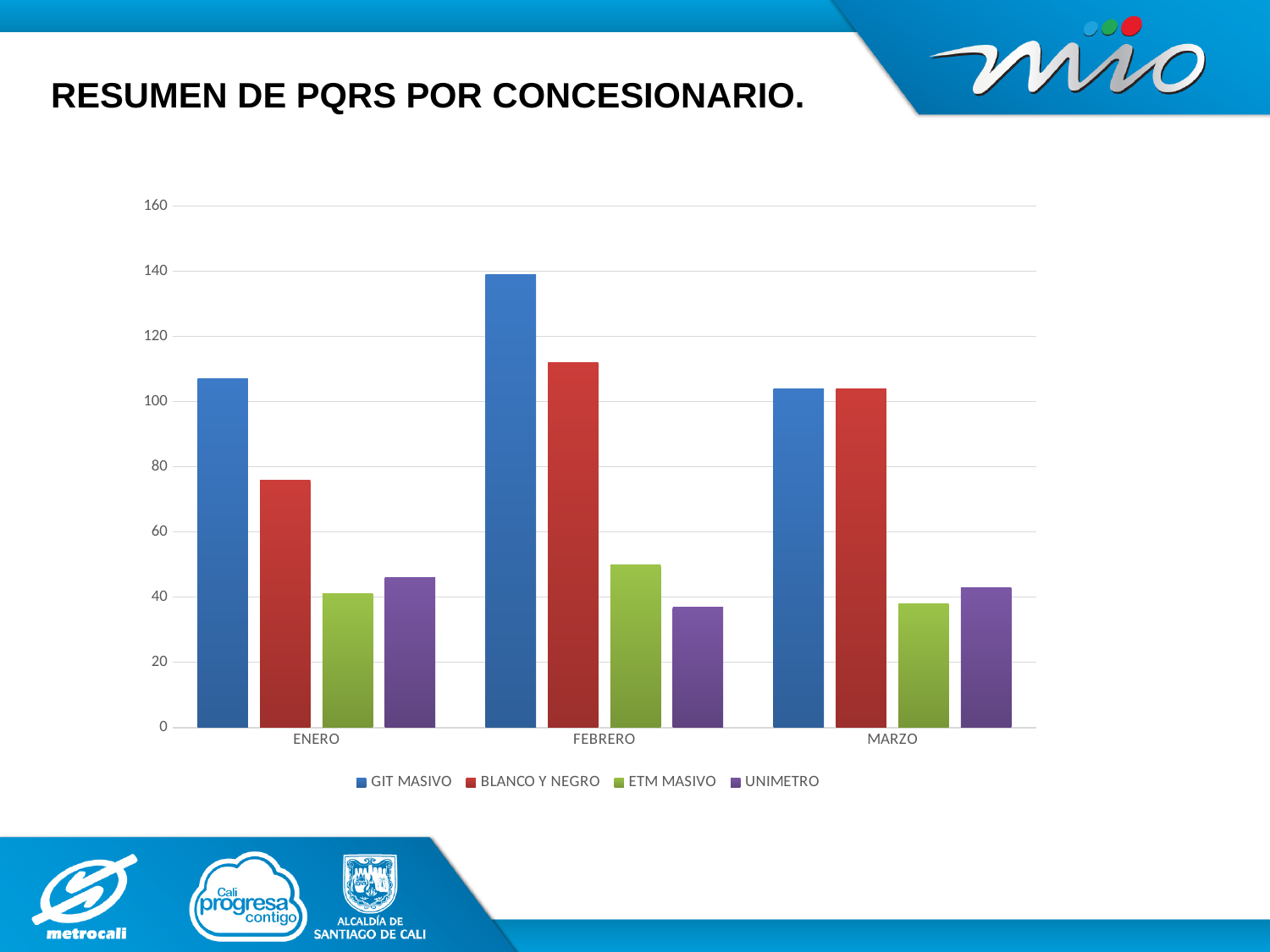
In FEBRERO, which is larger: ETM MASIVO or UNIMETRO? ETM MASIVO How many months are shown on the x axis? 3 Is the value for GIT MASIVO in FEBRERO greater or less than 120? greater Is the value for BLANCO Y NEGRO in FEBRERO greater or less than 100? greater What is the title of the slide containing the chart? RESUMEN DE PQRS POR CONCESIONARIO. Which series has the highest bar in ENERO? GIT MASIVO In which month is the UNIMETRO bar lowest? FEBRERO Does the BLANCO Y NEGRO value rise or fall from ENERO to FEBRERO? rise In which month is the GIT MASIVO bar highest? FEBRERO How many series does the legend list? 4 What kind of chart is shown on the slide? bar chart